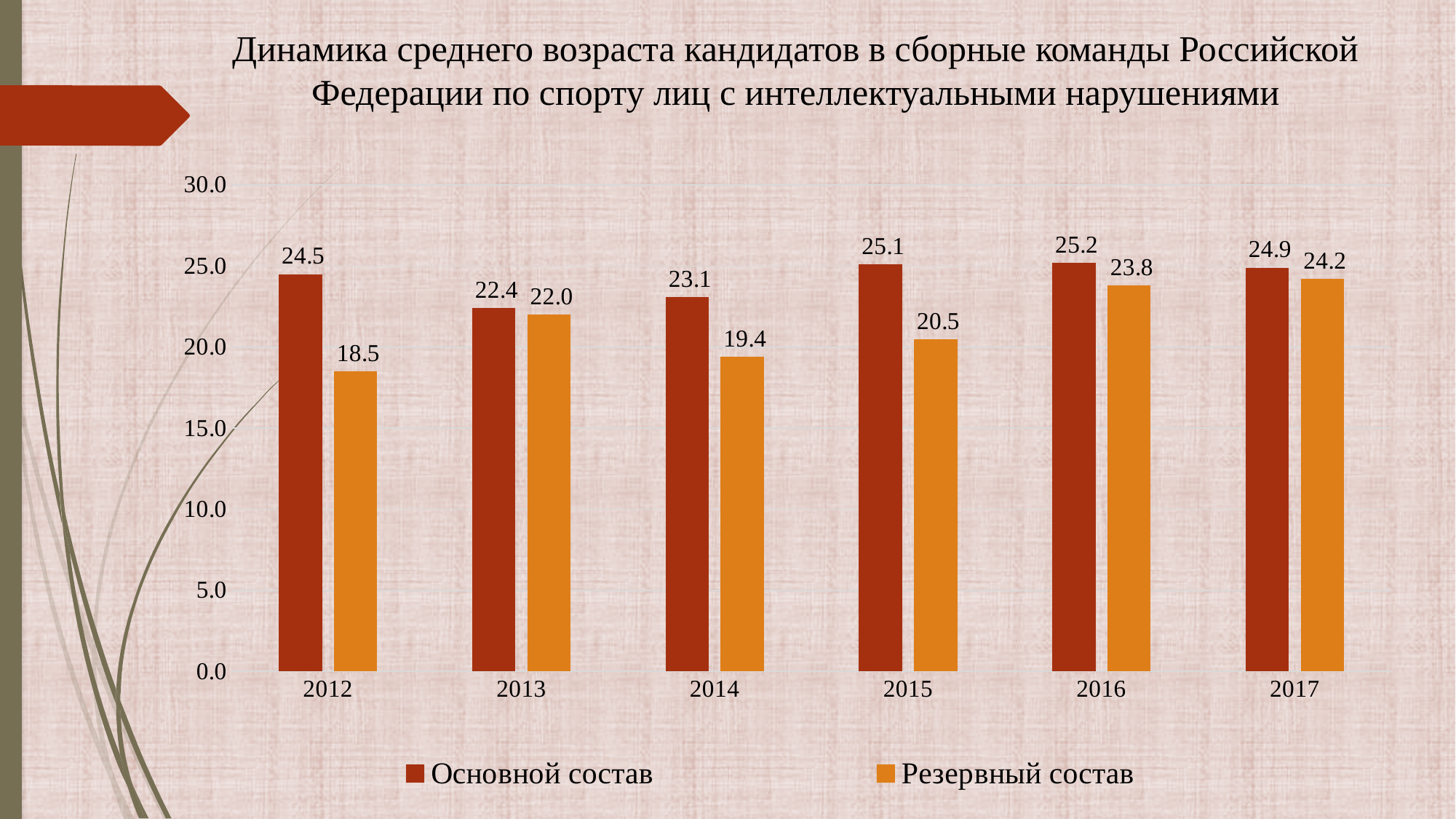
In which year is the value for Основной состав highest? 2016 How many series does the legend list? 2 What is the value for Резервный состав in 2017? 24.2 What is the difference between Основной состав and Резервный состав in 2015? 4.6 In which year is the value for Резервный состав lowest? 2012 What is the value for Резервный состав in 2014? 19.4 How many years are shown on the x axis? 6 Is the value for Резервный состав in 2016 greater or less than 20.0? greater What is the difference between Основной состав and Резервный состав in 2012? 6.0 What kind of chart is shown on the slide? bar chart What is the value for Основной состав in 2012? 24.5 Which is larger in 2013: Основной состав or Резервный состав? Основной состав